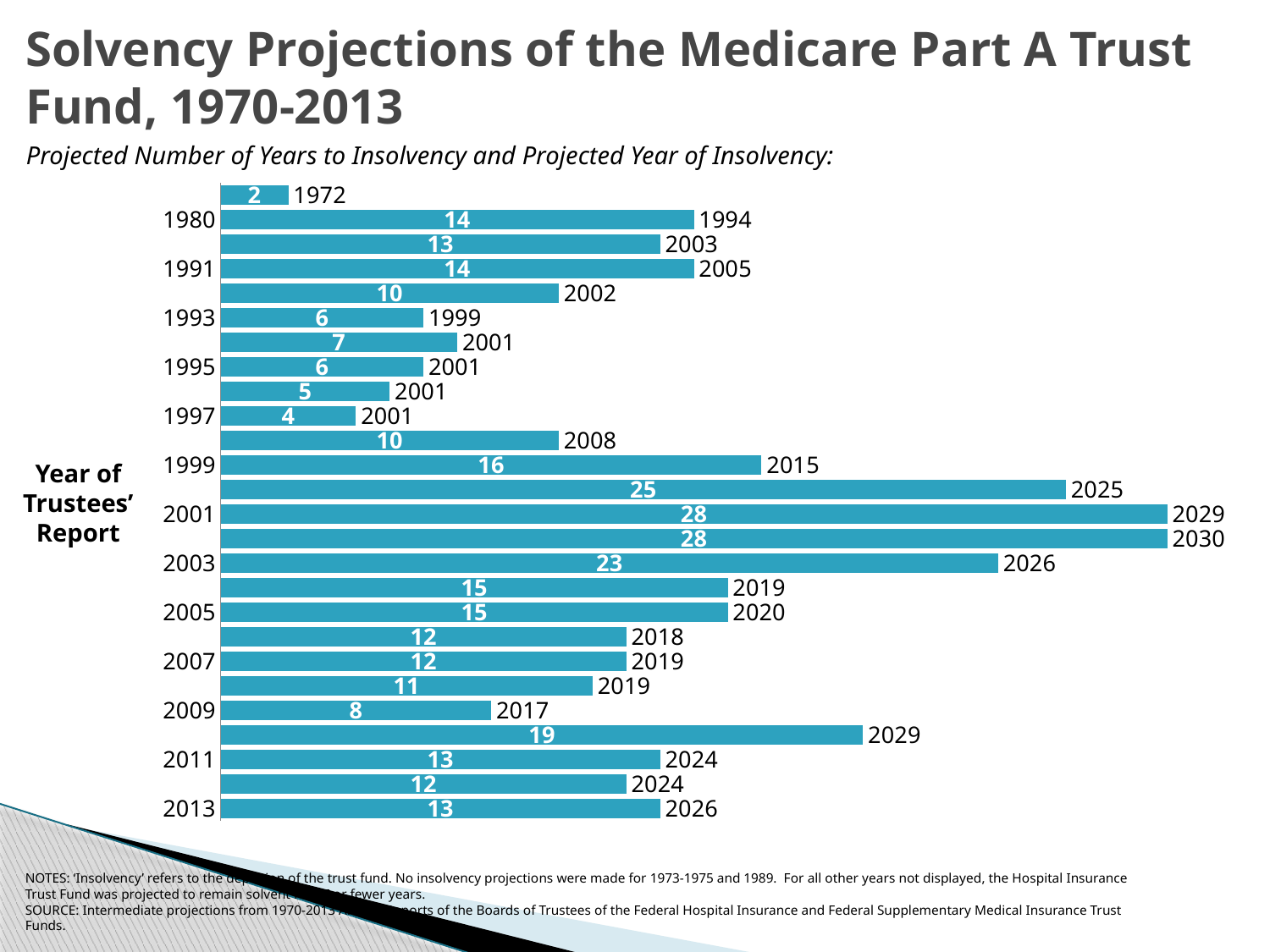
What kind of chart is shown on the slide? Bar chart What label is given to the vertical axis of the chart? Year of Trustees' Report What is the difference in projected years to insolvency between the 1999 and 2009 Trustees' Reports? 8 What is the projected number of years to insolvency for the 2003 Trustees' Report? 23 What is the projected year of insolvency shown for the 2013 Trustees' Report? 2026 What is the projected number of years to insolvency for the 1999 Trustees' Report? 16 How many bars are plotted on the chart? 26 What is the smallest projected number of years to insolvency shown on the chart? 2 How many years to insolvency were projected in the 2009 Trustees' Report? 8 What is the difference in projected years to insolvency between the 2001 and 2013 Trustees' Reports? 15 What projected year of insolvency is shown for the 1991 Trustees' Report? 2005 Which Trustees' Report projected more years to insolvency, 1980 or 1997? 1980